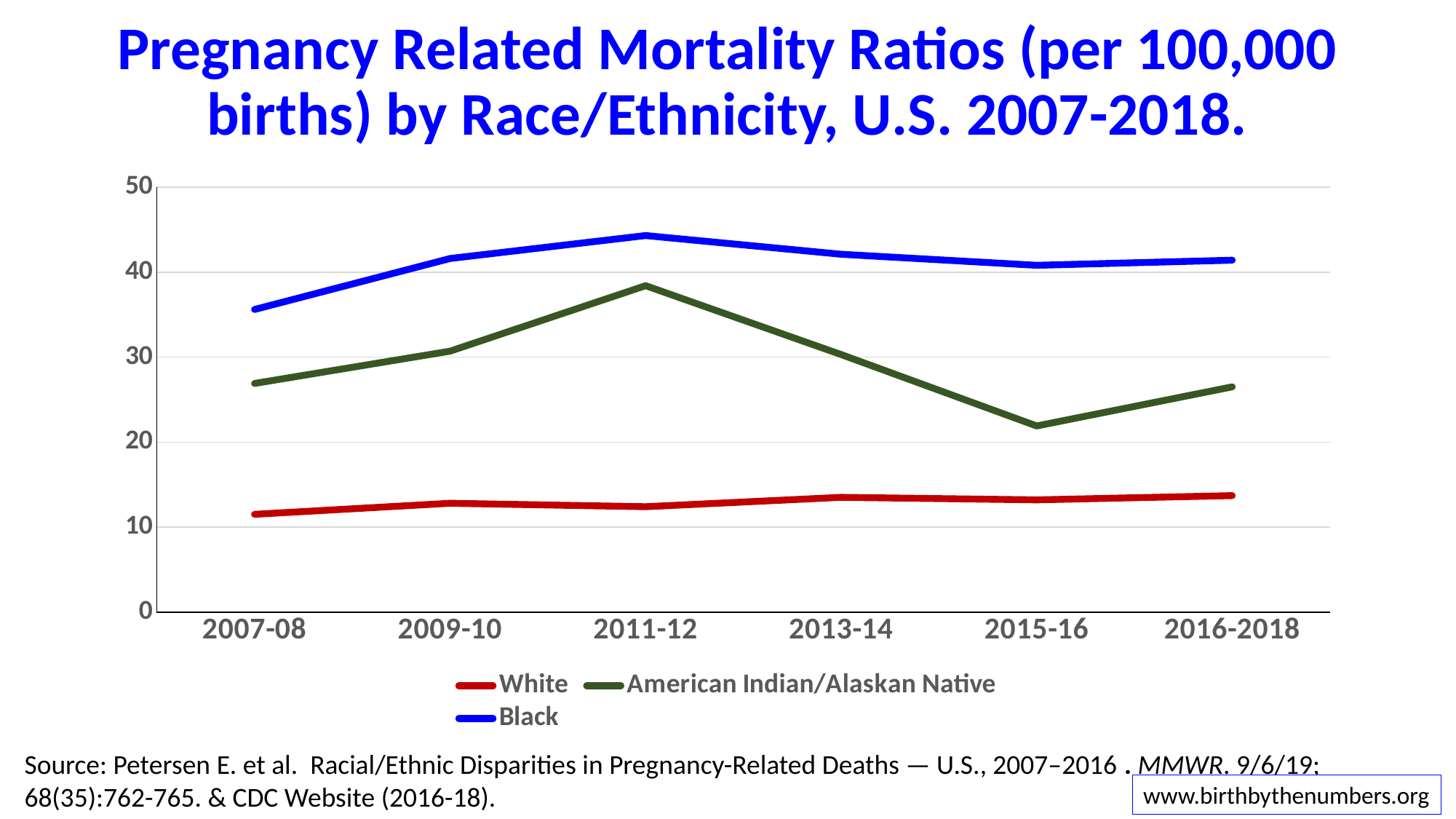
In which period is the American Indian/Alaskan Native series at its lowest? 2015-16 Is the value for Black in 2007-08 greater or less than 40? less How many series does the legend list? 3 In which period is the American Indian/Alaskan Native series at its highest? 2011-12 Which series is higher in 2013-14, White or American Indian/Alaskan Native? American Indian/Alaskan Native How many time periods are shown on the x axis? 6 In which period is the Black series at its highest? 2011-12 In which period is the Black series at its lowest? 2007-08 Is the value for American Indian/Alaskan Native in 2015-16 greater or less than 20? greater Is the value for Black in 2011-12 greater or less than 40? greater What kind of chart is shown on the slide? line chart Which colour is used for the Black series? blue